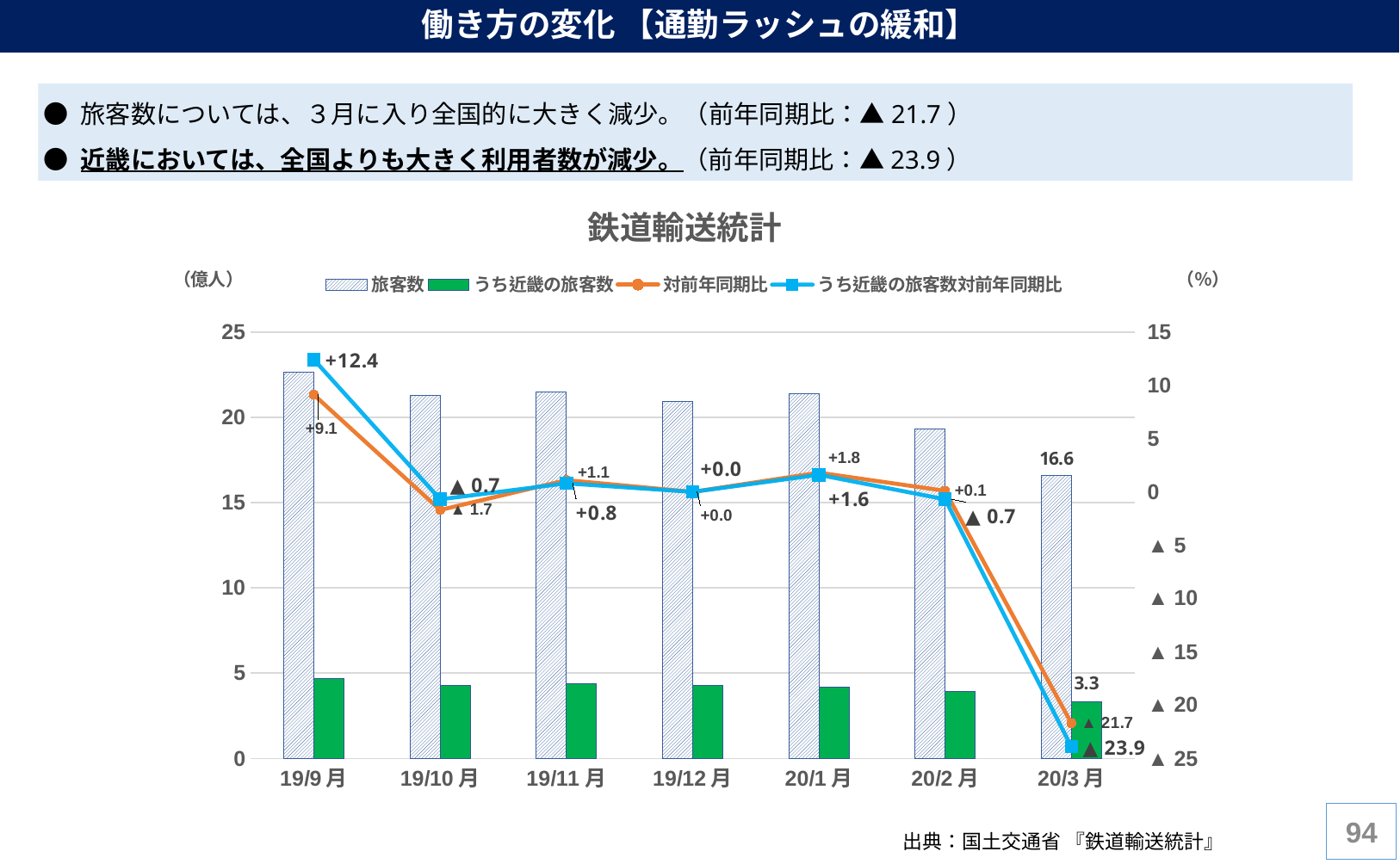
What is the 対前年同期比 value for 19/9月? +9.1 What is the うち近畿の旅客数対前年同期比 value for 20/3月? ▲23.9 What kind of chart is shown on the slide? A combined bar and line chart Is the 旅客数 value for 19/9月 greater or less than 20? greater What is the value of うち近畿の旅客数 for 20/3月? 3.3 What is the うち近畿の旅客数対前年同期比 value for 19/9月? +12.4 How many series does the chart legend list? 4 How many months are shown on the x axis of the chart? 7 What is the value of 旅客数 for 20/3月? 16.6 What is the 対前年同期比 value for 20/3月? ▲21.7 What is the difference between 旅客数 and うち近畿の旅客数 for 20/3月? 13.3 Which month has the lowest 旅客数 bar? 20/3月